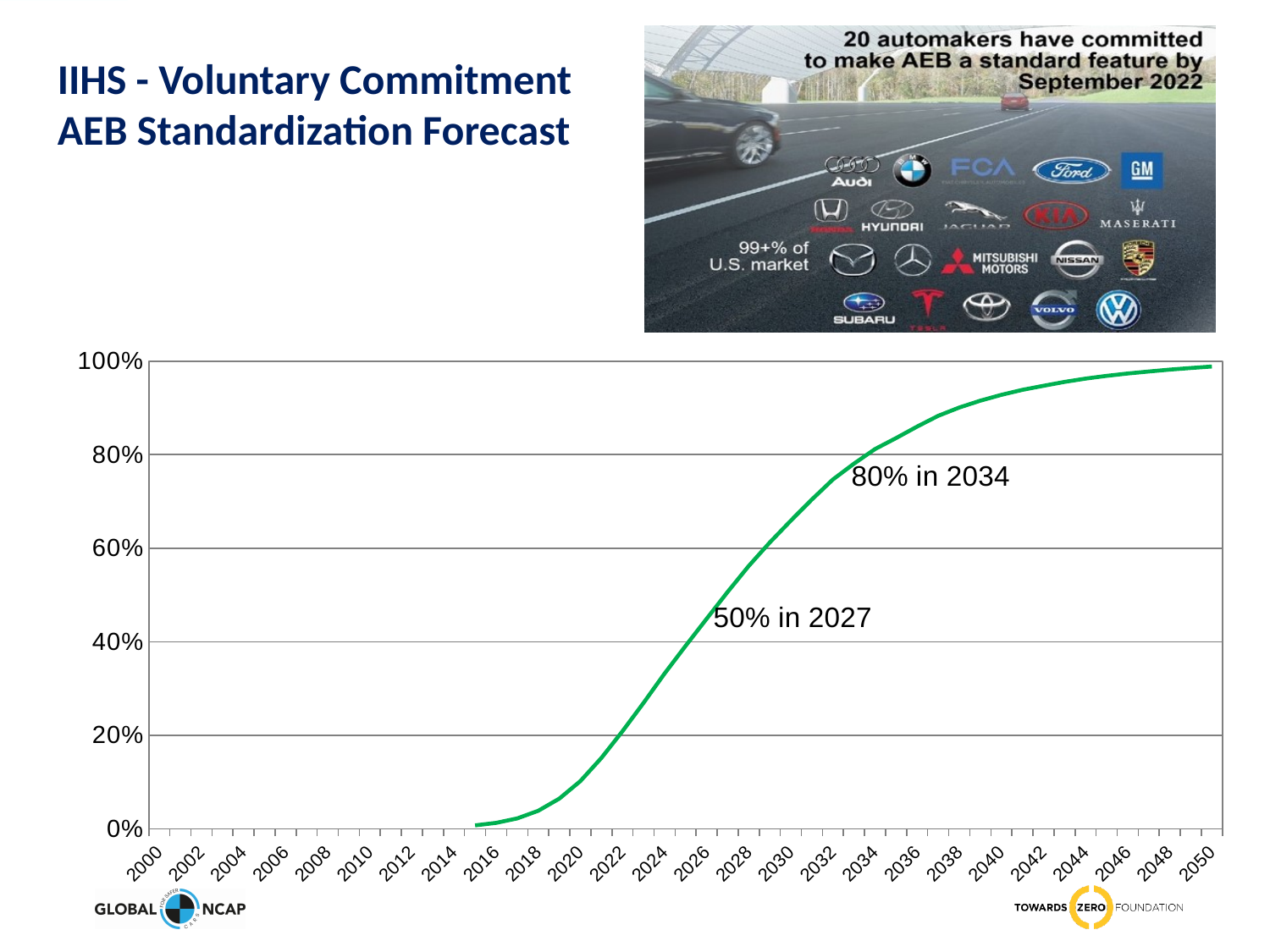
Is the value for 2020 greater or less than 20%? less What colour is the line plotted on the chart? green Is the value for 2040 greater or less than 80%? greater What kind of chart is shown on the slide? line chart Which year has the larger annotated value, 2027 or 2034? 2034 According to the chart annotation, what value does the line reach in 2034? 80% Is the value for 2024 greater or less than 40%? less What is the difference between the annotated value for 2034 and the annotated value for 2027? 30 percentage points In which year does the chart annotation say the line reaches 80%? 2034 In which year does the chart annotation say the line reaches 50%? 2027 According to the chart annotation, what value does the line reach in 2027? 50% Does the line rise or fall as the years increase along the x axis? rise